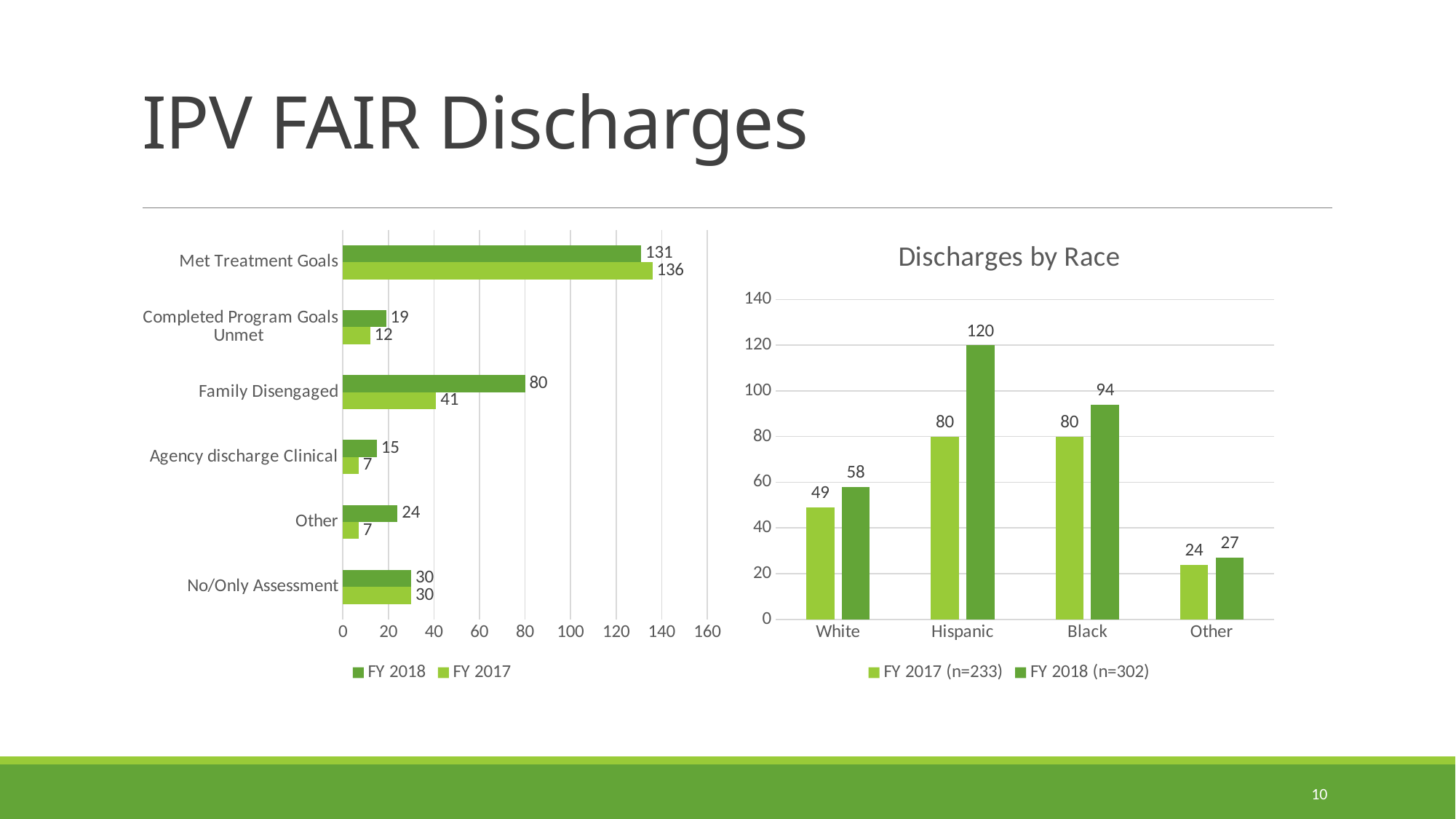
In the left chart, which is larger for Completed Program Goals Unmet: FY 2018 or FY 2017? FY 2018 What kind of chart is the Discharges by Race chart? Bar chart In the left chart, how many categories are shown? 6 In the left chart, what is the FY 2017 value for Met Treatment Goals? 136 In the left chart, what is the difference between the FY 2018 and FY 2017 values for Family Disengaged? 39 In the Discharges by Race chart, how many series does the legend list? 2 In the left chart, what is the FY 2018 value for Family Disengaged? 80 In the Discharges by Race chart, what are the legend entries? FY 2017 (n=233) and FY 2018 (n=302) In the left chart, which category has the highest FY 2018 value? Met Treatment Goals In the Discharges by Race chart, which race has the lowest FY 2017 value? Other In the Discharges by Race chart, what is the FY 2018 value for Hispanic? 120 In the Discharges by Race chart, what is the difference between the FY 2018 and FY 2017 values for Black? 14